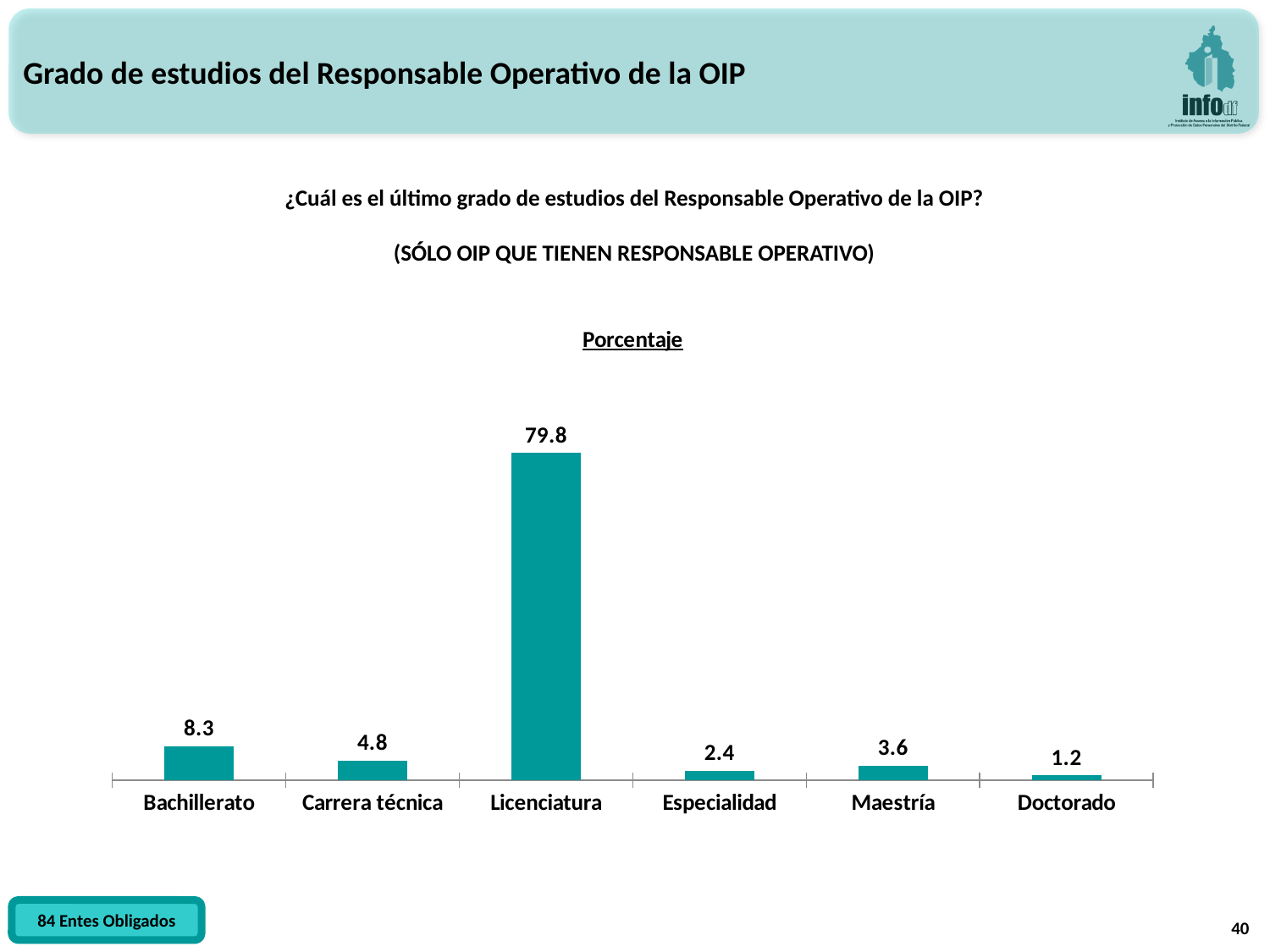
What is the difference between the values for Maestría and Especialidad? 1.2 What is the underlined label above the chart? Porcentaje Which category has the highest value? Licenciatura What is the value for Maestría? 3.6 Which category has the lowest value? Doctorado What kind of chart is shown on the slide? Bar chart What is the value for Doctorado? 1.2 Which is larger, the value for Carrera técnica or the value for Maestría? Carrera técnica What is the difference between the values for Bachillerato and Carrera técnica? 3.5 What is the value for Licenciatura? 79.8 How many categories are shown on the x axis? 6 What is the value for Bachillerato? 8.3